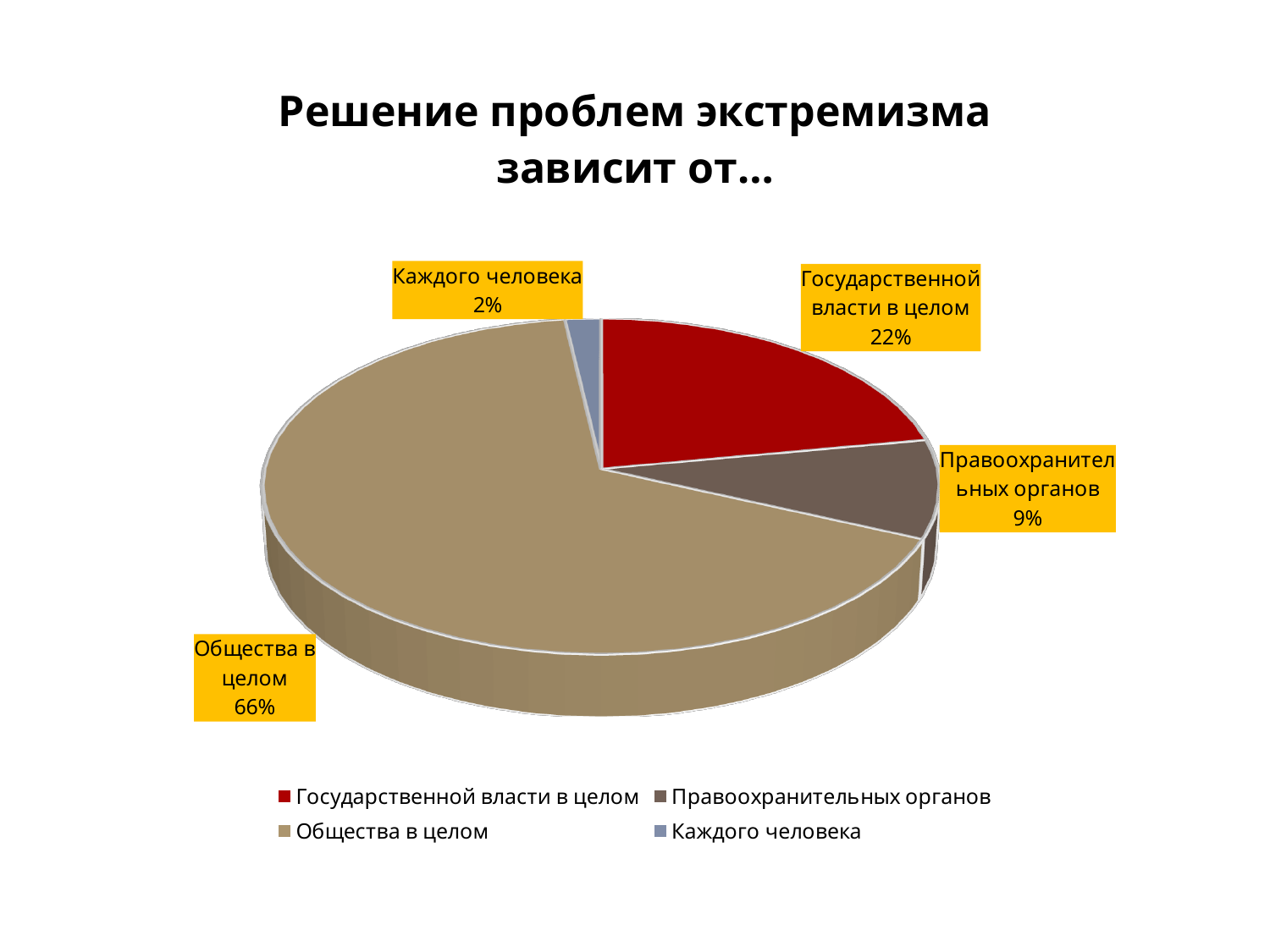
What is the value shown for "Государственной власти в целом"? 22% Which category has the largest slice of the pie? Общества в целом What is the difference between the values for "Государственной власти в целом" and "Правоохранительных органов"? 13% What is the value shown for "Правоохранительных органов"? 9% Which category has the smallest slice of the pie? Каждого человека What is the difference between the values for "Общества в целом" and "Государственной власти в целом"? 44% Which is larger: the slice for "Правоохранительных органов" or the slice for "Каждого человека"? Правоохранительных органов What is the value shown for "Каждого человека"? 2% What kind of chart is shown on the slide? Pie chart What is the title of the chart? Решение проблем экстремизма зависит от… What share of the pie does "Общества в целом" hold? 66% How many categories are shown in the pie chart? 4